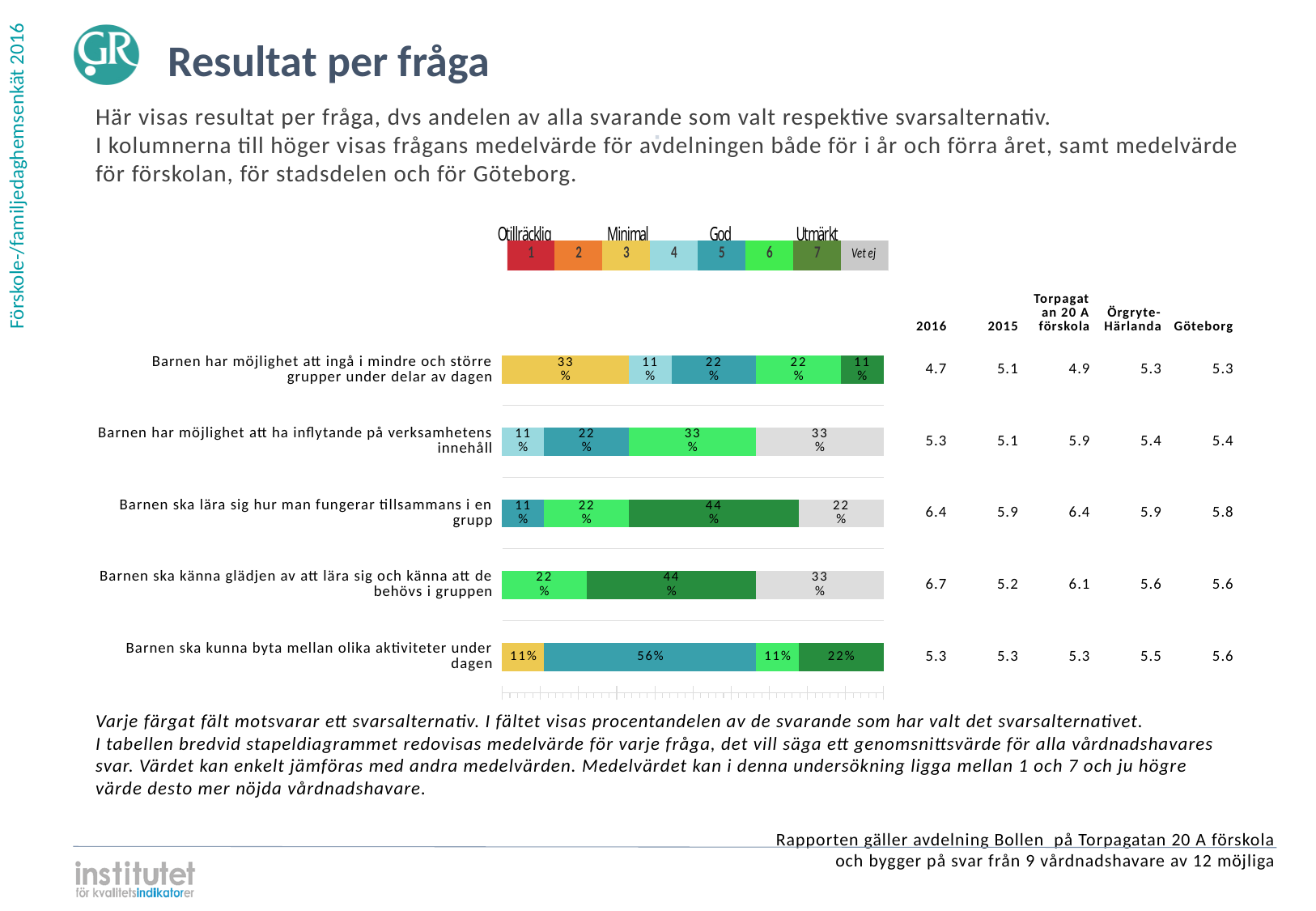
How many questions (bars) are shown in the chart? 5 Which question has the highest 2016 mean value? Barnen ska känna glädjen av att lära sig och känna att de behövs i gruppen What percentage of respondents chose answer alternative 5 for 'Barnen ska kunna byta mellan olika aktiviteter under dagen'? 56% Which question has the lowest 2016 mean value? Barnen har möjlighet att ingå i mindre och större grupper under delar av dagen How many answer alternatives does the legend above the chart list (including 'Vet ej')? 8 What percentage of respondents answered 'Vet ej' for 'Barnen ska känna glädjen av att lära sig och känna att de behövs i gruppen'? 33% What is the 2016 mean value for 'Barnen ska känna glädjen av att lära sig och känna att de behövs i gruppen'? 6.7 What is the difference between the 2016 and 2015 mean values for 'Barnen ska känna glädjen av att lära sig och känna att de behövs i gruppen'? 1.5 What kind of chart is used to show the results per question on this slide? Stacked bar chart What is the Göteborg mean value for 'Barnen ska lära sig hur man fungerar tillsammans i en grupp'? 5.8 For 'Barnen har möjlighet att ingå i mindre och större grupper under delar av dagen', which is larger: the 2016 mean or the Göteborg mean? Göteborg mean What percentage of respondents chose answer alternative 7 for 'Barnen ska lära sig hur man fungerar tillsammans i en grupp'? 44%